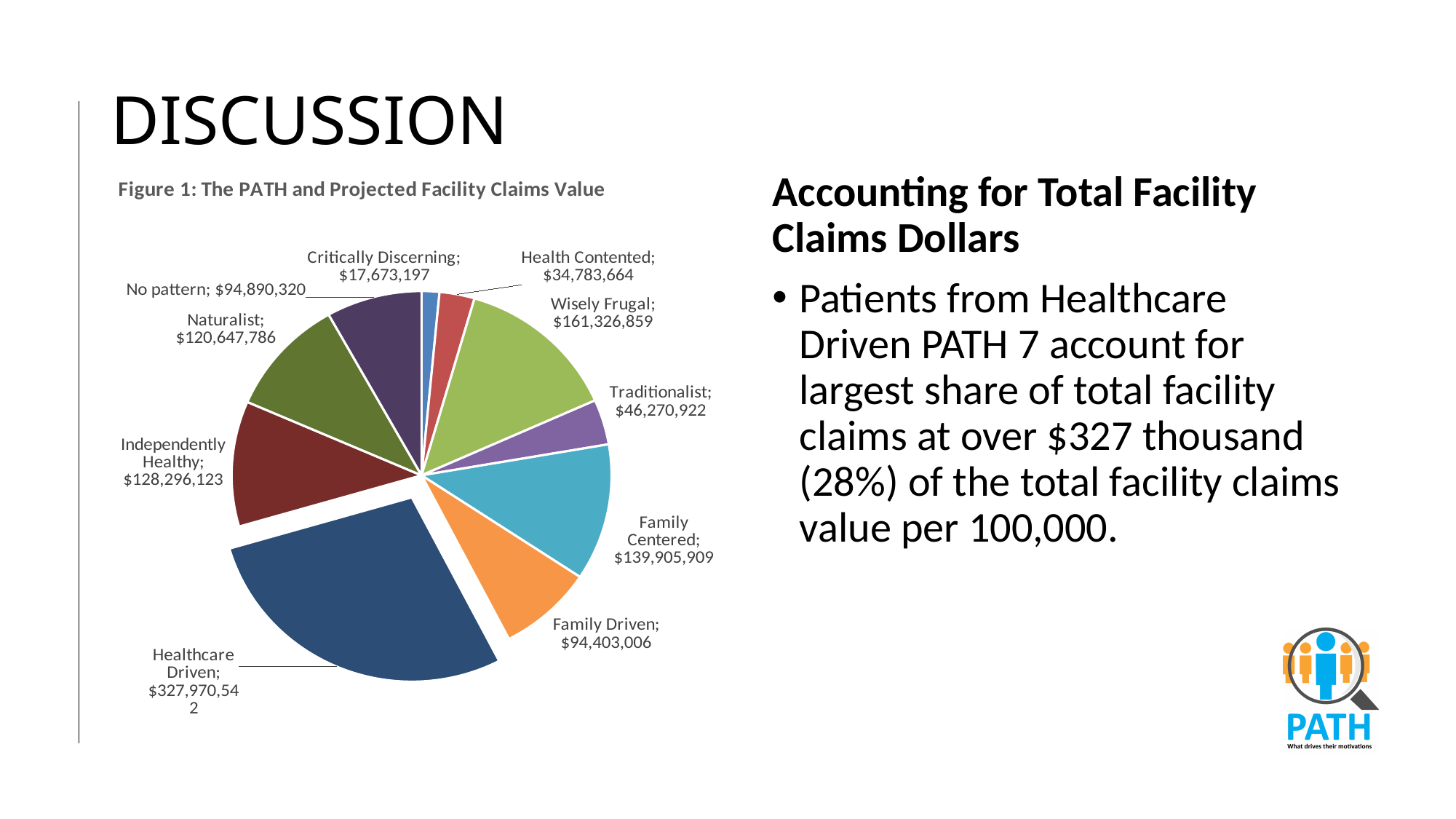
Which has a larger facility claims value, Wisely Frugal or Family Centered? Wisely Frugal What is the facility claims value for Wisely Frugal? $161,326,859 Which PATH category has the largest facility claims value? Healthcare Driven What is the facility claims value for Family Centered? $139,905,909 What type of chart is shown in Figure 1? Pie chart Which PATH category has the smallest facility claims value? Critically Discerning What is the difference between the Wisely Frugal and Family Centered facility claims values? $21,420,950 What is the difference between the Healthcare Driven and Wisely Frugal facility claims values? $166,643,683 What is the facility claims value for Independently Healthy? $128,296,123 What is the title of the chart on the slide? Figure 1: The PATH and Projected Facility Claims Value What is the facility claims value for Traditionalist? $46,270,922 How many PATH categories are shown in the pie chart? 10